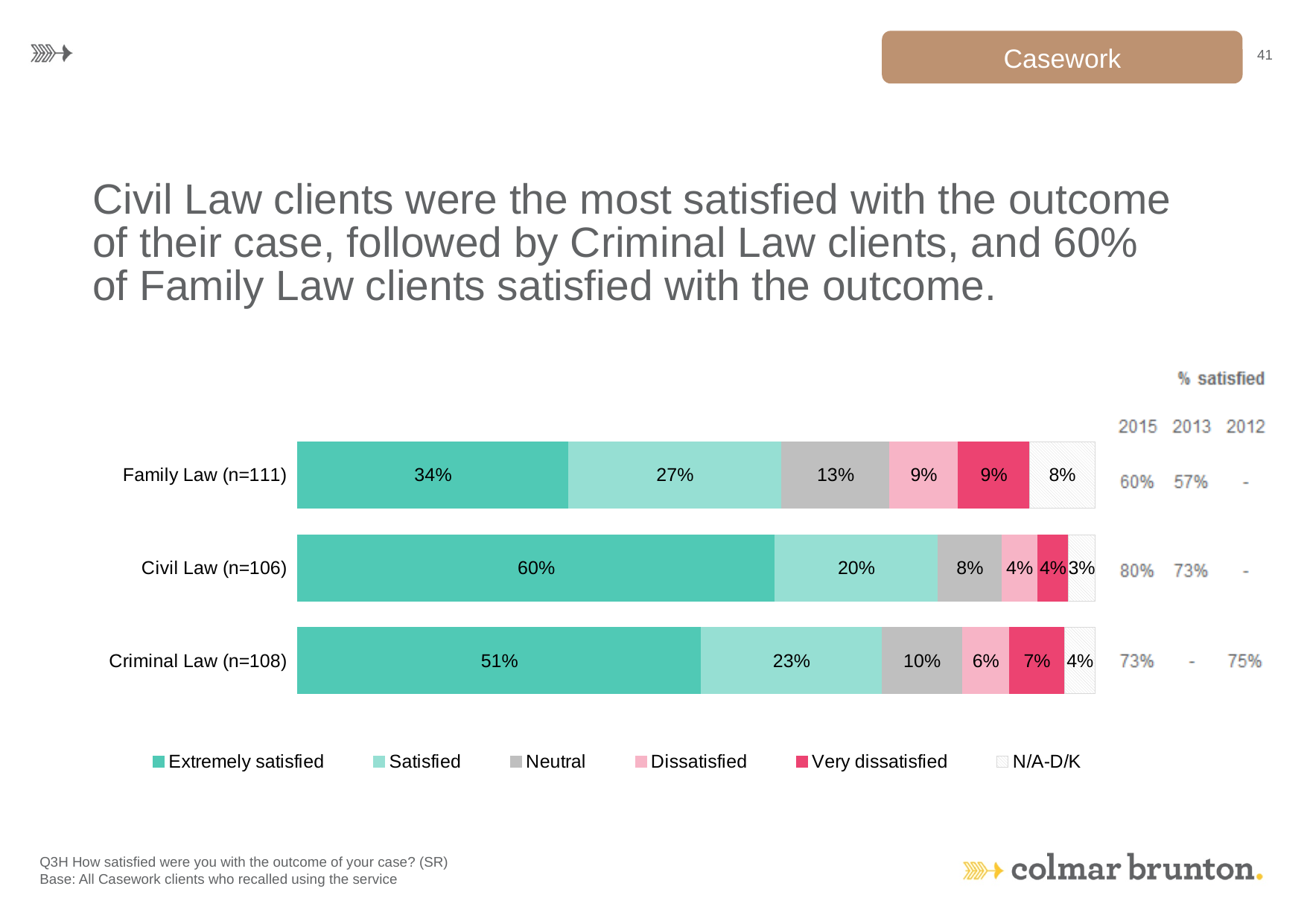
What percentage of Family Law clients were very dissatisfied with the outcome? 9% Which is larger: the neutral share for Family Law clients or for Criminal Law clients? Family Law How many client groups (bars) are shown in the chart? 3 What percentage of Family Law clients were extremely satisfied with the outcome of their case? 34% How many series does the legend list? 6 Which client group has the lowest share of extremely satisfied clients? Family Law (n=111) What percentage of Criminal Law clients were neutral about the outcome of their case? 10% Which client group has the highest share of extremely satisfied clients? Civil Law (n=106) What kind of chart is shown on the slide? Stacked bar chart What is the difference between the extremely satisfied percentages for Civil Law and Family Law clients? 26% What percentage of Civil Law clients were satisfied (not extremely satisfied) with the outcome? 20%